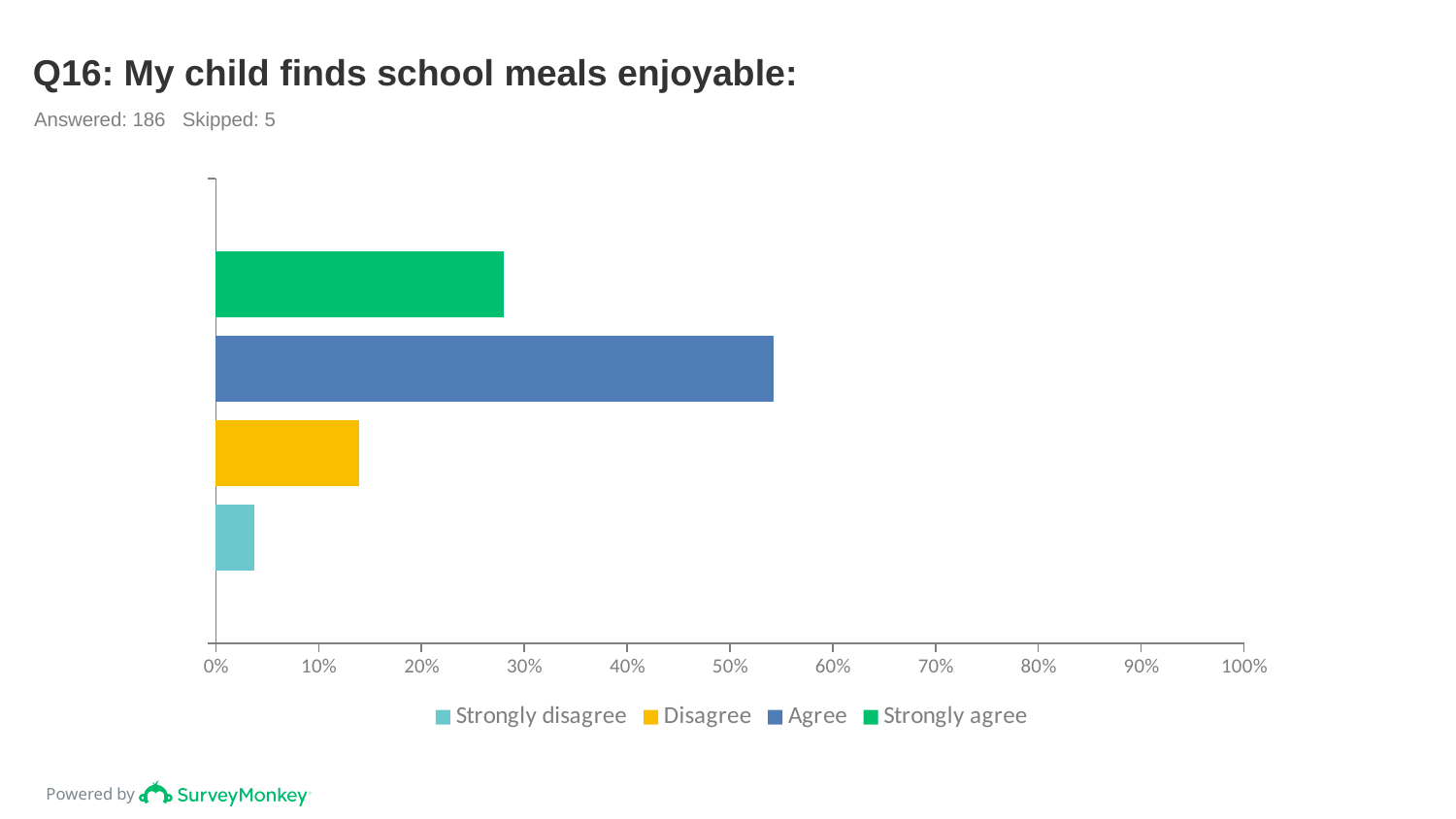
What is the title of the chart? Q16: My child finds school meals enjoyable: Which response has the shortest bar? Strongly disagree Which is larger, the value for Agree or the value for Strongly agree? Agree What kind of chart is shown on the slide? bar chart Is the value for Agree greater or less than 50%? greater Is the value for Disagree greater or less than 10%? greater Is the value for Strongly agree greater or less than 30%? less How many bars are plotted in the chart? 4 How many series does the legend list? 4 Which response has the longest bar? Agree Which is larger, the value for Strongly agree or the value for Disagree? Strongly agree